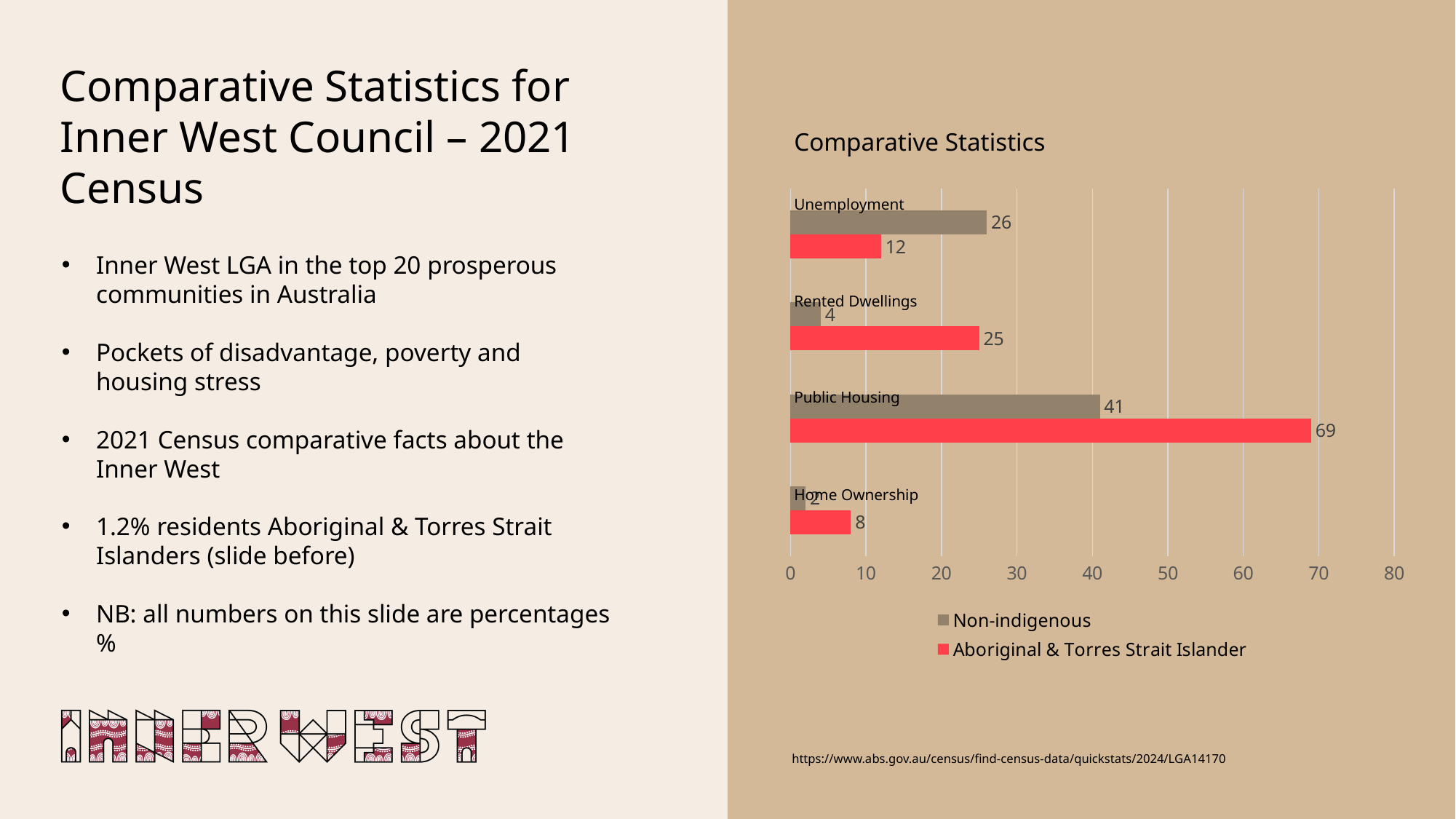
What is the Aboriginal & Torres Strait Islander value for Public Housing? 69 What is the difference between the Aboriginal & Torres Strait Islander and Non-indigenous values for Public Housing? 28 What is the Aboriginal & Torres Strait Islander value for Rented Dwellings? 25 How many series does the legend list? 2 What kind of chart is shown on the slide? bar chart What is the Non-indigenous value for Rented Dwellings? 4 For Unemployment, which is larger: the Non-indigenous value or the Aboriginal & Torres Strait Islander value? Non-indigenous Which category has the lowest Aboriginal & Torres Strait Islander value? Home Ownership How many categories are shown on the chart? 4 What is the Non-indigenous value for Unemployment? 26 Is the Non-indigenous value for Home Ownership greater or less than 10? less Which category has the highest Aboriginal & Torres Strait Islander value? Public Housing